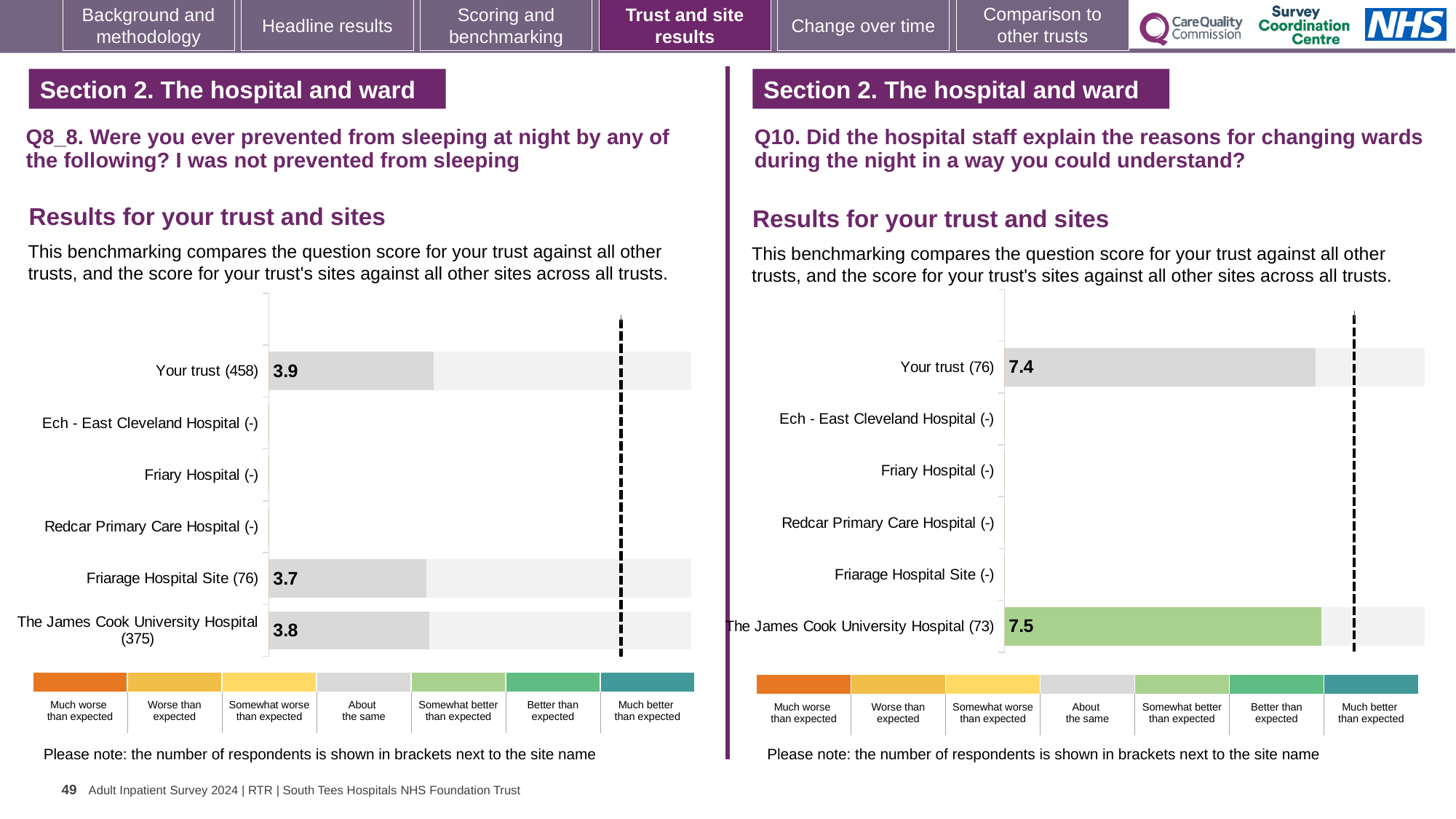
On the left chart (Q8_8), what is the score for The James Cook University Hospital (375)? 3.8 On the right chart (Q10), what is the score for Your trust (76)? 7.4 How many rows (trust and sites) are listed on the left chart (Q8_8)? 6 On the left chart (Q8_8), what is the difference between the score for Your trust (458) and Friarage Hospital Site (76)? 0.2 On the left chart (Q8_8), what is the score for Friarage Hospital Site (76)? 3.7 On the right chart (Q10), what is the difference between the score for The James Cook University Hospital (73) and Your trust (76)? 0.1 On the right chart (Q10), what colour is the bar for The James Cook University Hospital (73)? Green On the right chart (Q10), what is the score for The James Cook University Hospital (73)? 7.5 What type of chart is used on the right side of the slide (Q10)? Bar chart On the left chart (Q8_8), which site or trust row has the lowest score shown? Friarage Hospital Site (76) On the right chart (Q10), which has the higher score: Your trust (76) or The James Cook University Hospital (73)? The James Cook University Hospital (73) On the left chart (Q8_8), what is the score for Your trust (458)? 3.9